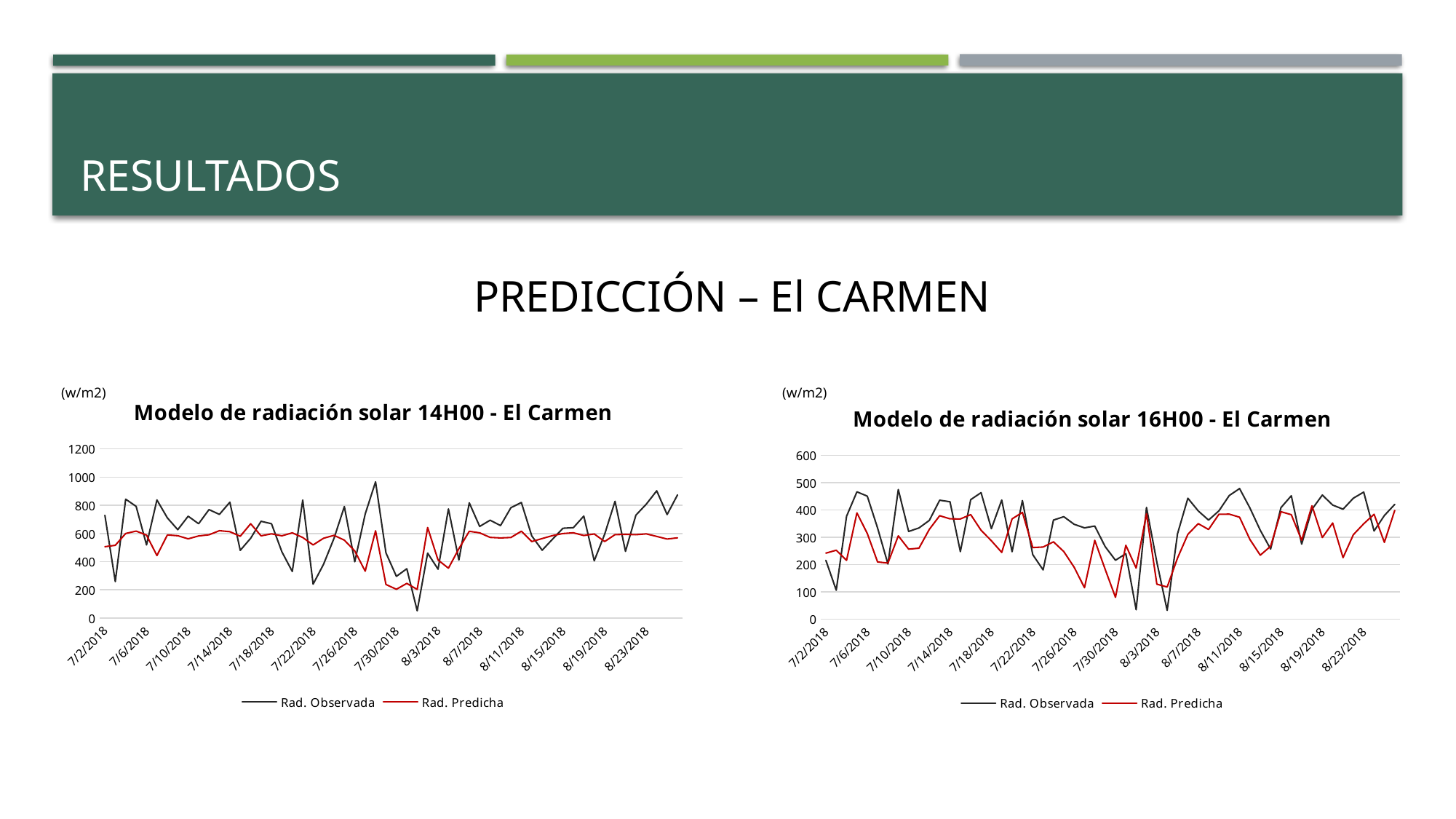
How many series does the legend of the "Modelo de radiación solar 14H00 - El Carmen" chart list? 2 In the "Modelo de radiación solar 16H00 - El Carmen" chart, is the lowest value of Rad. Observada greater or less than 100? less In the "Modelo de radiación solar 14H00 - El Carmen" chart, is the highest value of Rad. Observada greater or less than 800? greater In the "Modelo de radiación solar 16H00 - El Carmen" chart, is the highest value of Rad. Observada greater or less than 400? greater What unit is shown above the y axis of the "Modelo de radiación solar 14H00 - El Carmen" chart? (w/m2) How many series does the legend of the "Modelo de radiación solar 16H00 - El Carmen" chart list? 2 In the "Modelo de radiación solar 16H00 - El Carmen" chart, what colour is the Rad. Predicha line? red What kind of chart is "Modelo de radiación solar 14H00 - El Carmen"? line chart In the "Modelo de radiación solar 14H00 - El Carmen" chart, which series has the larger value on 7/2/2018, Rad. Observada or Rad. Predicha? Rad. Observada What kind of chart is "Modelo de radiación solar 16H00 - El Carmen"? line chart In the "Modelo de radiación solar 16H00 - El Carmen" chart, which series has the larger value on 7/6/2018, Rad. Observada or Rad. Predicha? Rad. Observada